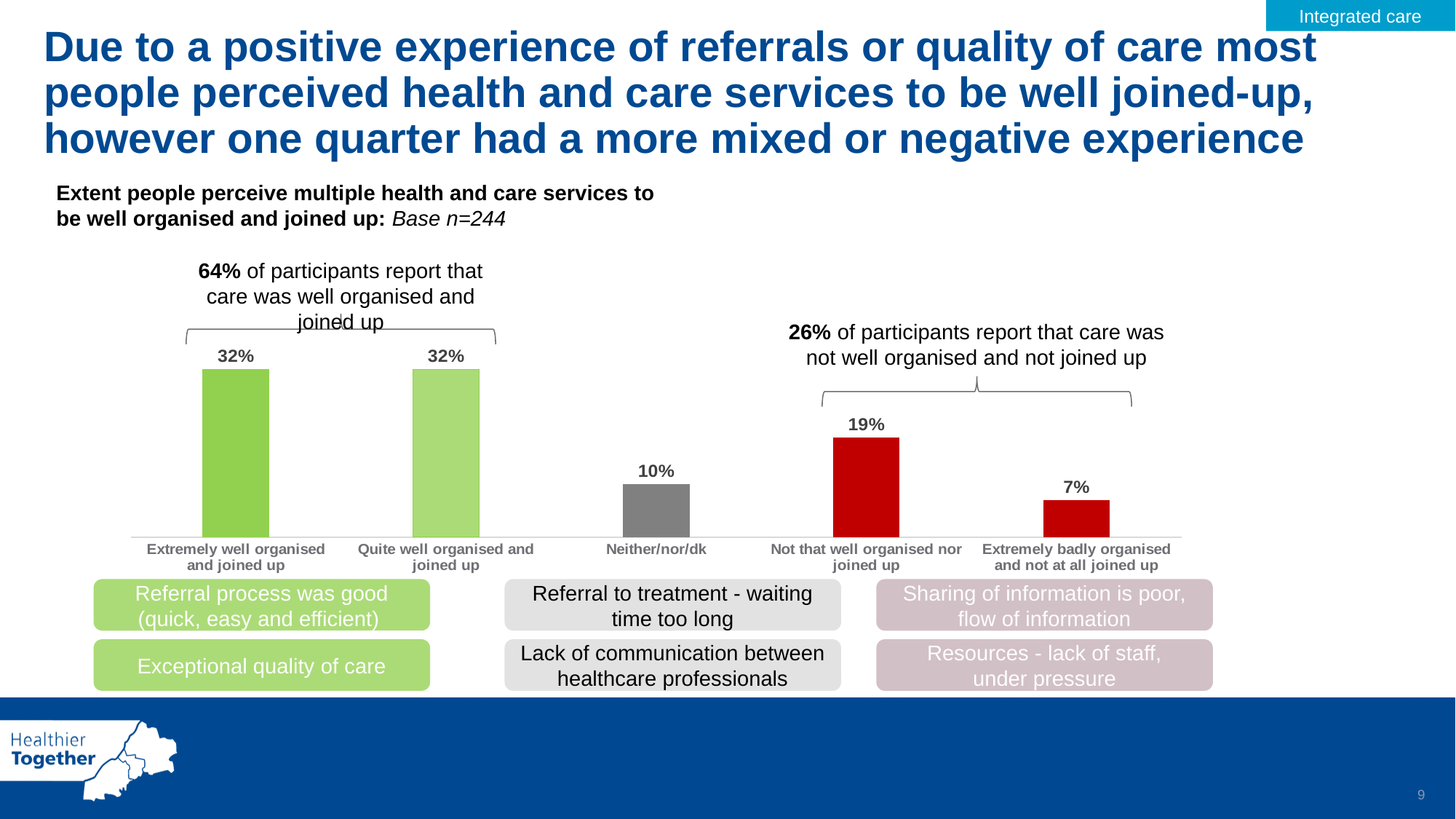
What is the value for 'Neither/nor/dk'? 10% What is the value for 'Extremely badly organised and not at all joined up'? 7% How many categories are shown on the chart? 5 What percentage of participants said services were 'Not that well organised nor joined up'? 19% Which is larger: the value for 'Neither/nor/dk' or the value for 'Not that well organised nor joined up'? Not that well organised nor joined up Which category has the lowest value? Extremely badly organised and not at all joined up What is the base sample size stated for the chart? n=244 What percentage of participants said services were 'Extremely well organised and joined up'? 32% What kind of chart is shown on the slide? Bar chart According to the annotation, what percentage of participants report that care was not well organised and not joined up? 26% What is the difference between 'Not that well organised nor joined up' and 'Extremely badly organised and not at all joined up'? 12% What is the difference between 'Quite well organised and joined up' and 'Neither/nor/dk'? 22%